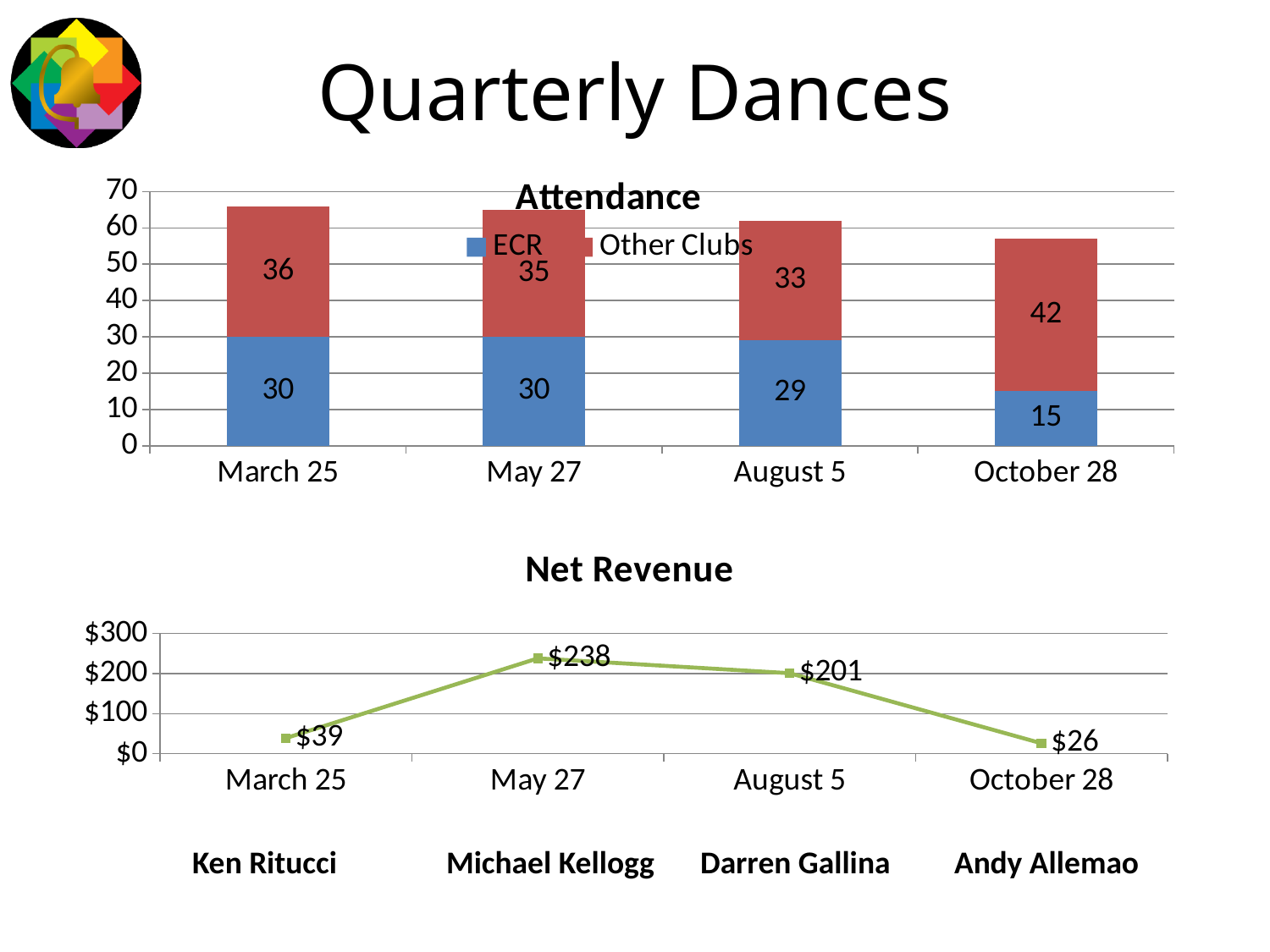
What kind of chart is the Attendance chart? Stacked bar chart In the Attendance chart, what is the total attendance for the October 28 bar? 57 In the Net Revenue chart, which date has the highest net revenue? May 27 In the Attendance chart, which date has the highest Other Clubs value? October 28 In the Attendance chart, what is the total attendance for the March 25 bar? 66 In the Attendance chart, what is the ECR value for October 28? 15 In the Attendance chart, what is the Other Clubs value for May 27? 35 In the Net Revenue chart, how many data points are plotted? 4 In the Net Revenue chart, what is the difference between the May 27 and October 28 values? $212 In the Net Revenue chart, what is the value for August 5? $201 In the Attendance chart, how many series does the legend list? 2 In the Attendance chart, which date has the lowest ECR value? October 28